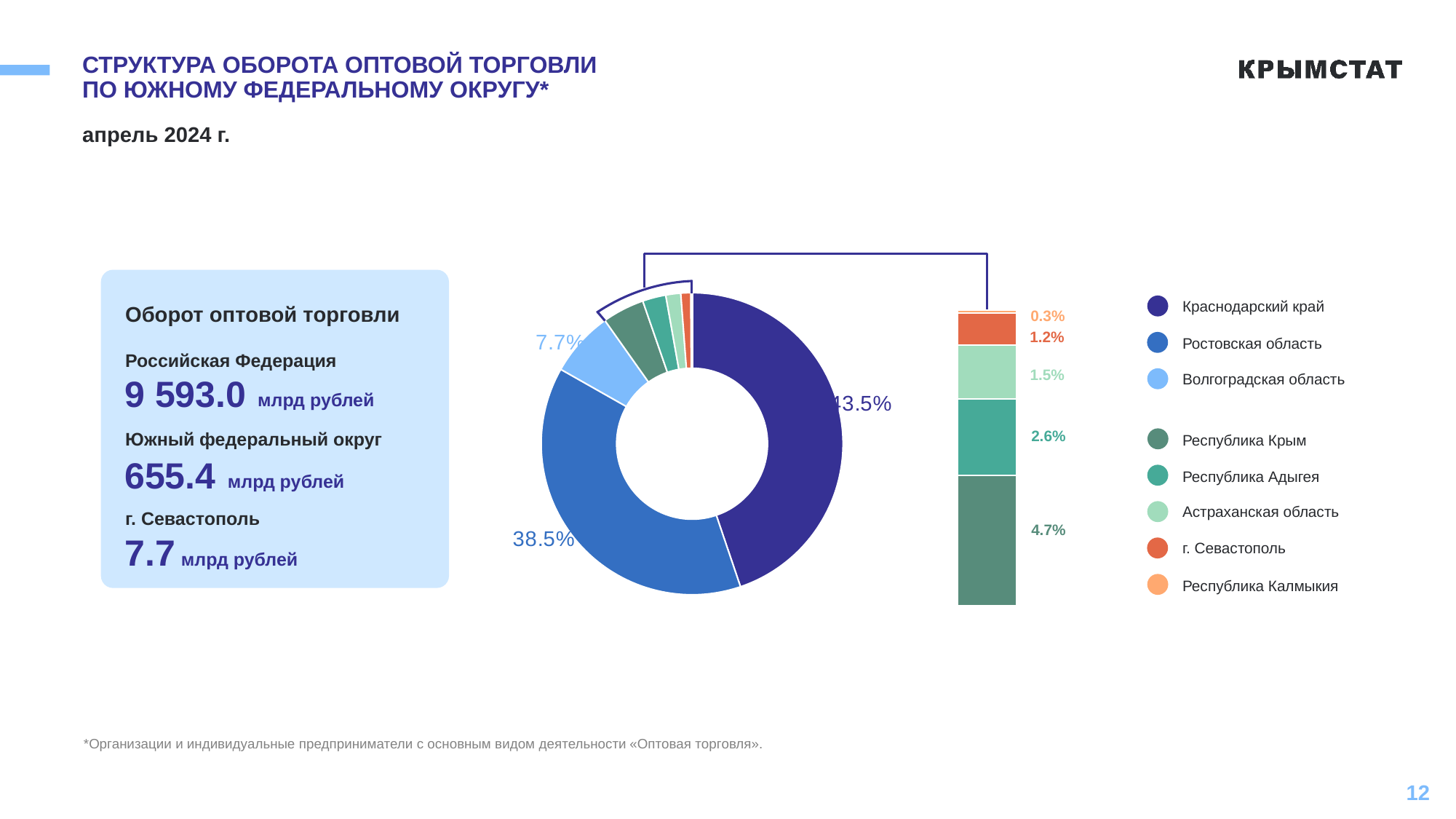
Which region has the smallest share of the wholesale trade turnover? Республика Калмыкия What share of wholesale trade turnover in the Southern Federal District does Краснодарский край account for? 43.5% What share is shown for Волгоградская область? 7.7% How many regions are listed in the chart legend? 8 Which region has the largest share of the wholesale trade turnover? Краснодарский край What share is shown for Республика Крым? 4.7% What share is shown for г. Севастополь? 1.2% By how many percentage points does the share of Краснодарский край exceed that of Ростовская область? 5.0 percentage points What share is shown for Ростовская область? 38.5% What type of chart is used to show the structure of wholesale trade turnover? Pie (donut) chart What is the combined share of the five small regions shown in the breakout stacked bar (Республика Крым, Республика Адыгея, Астраханская область, г. Севастополь, Республика Калмыкия)? 10.3% Which has the larger share, Республика Адыгея or Астраханская область? Республика Адыгея